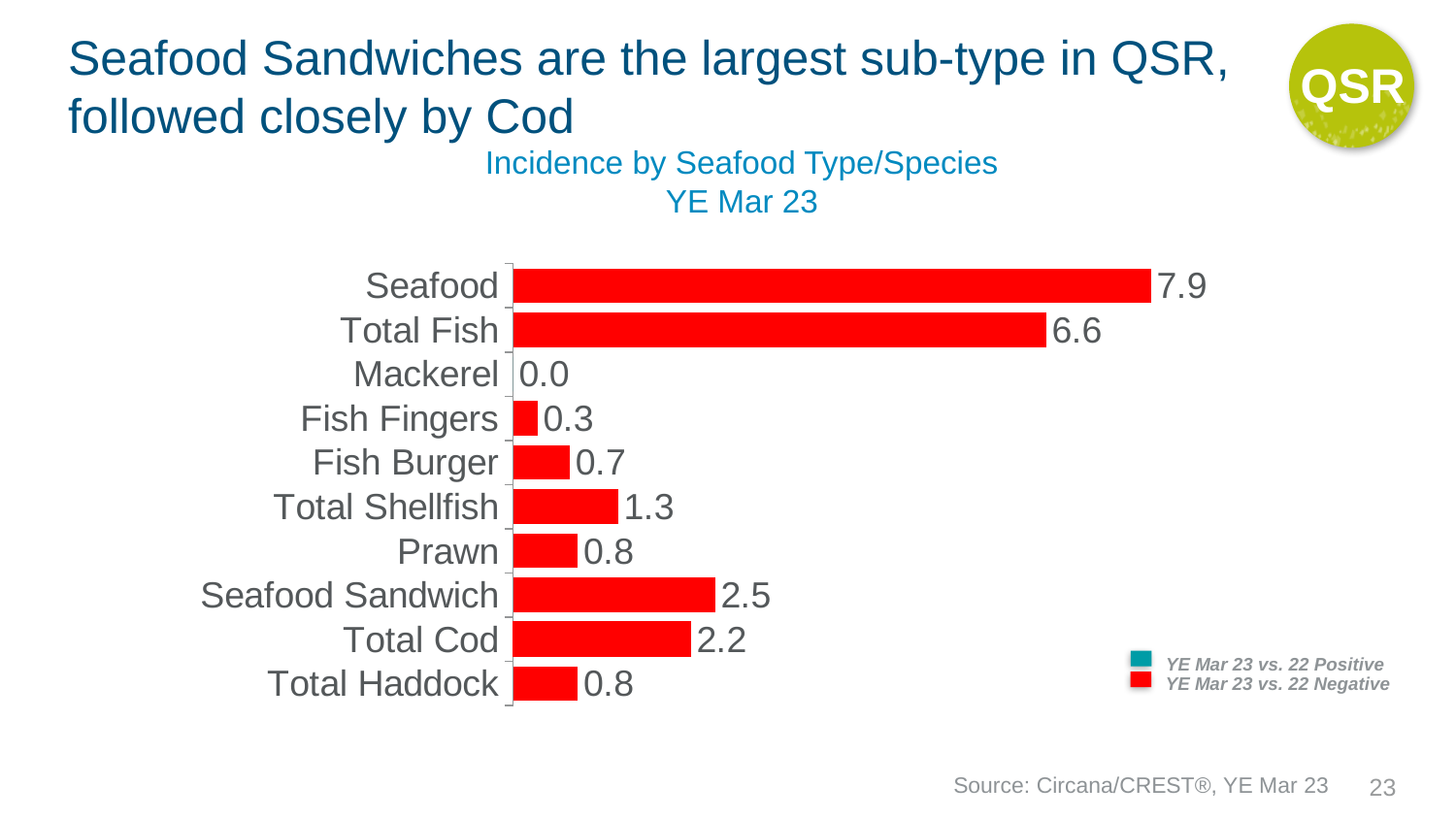
What is the difference between the values for Seafood Sandwich and Total Cod? 0.3 What is the value for Total Cod? 2.2 Which is larger, the value for Total Shellfish or the value for Fish Burger? Total Shellfish What is the value for Seafood Sandwich? 2.5 How many categories are shown in the chart? 10 What is the value for Total Fish? 6.6 What is the value for Seafood? 7.9 What kind of chart is shown on the slide? Bar chart Which category has the lowest value? Mackerel What is the value for Mackerel? 0.0 Which category has the highest value? Seafood What is the title of the chart? Incidence by Seafood Type/Species YE Mar 23